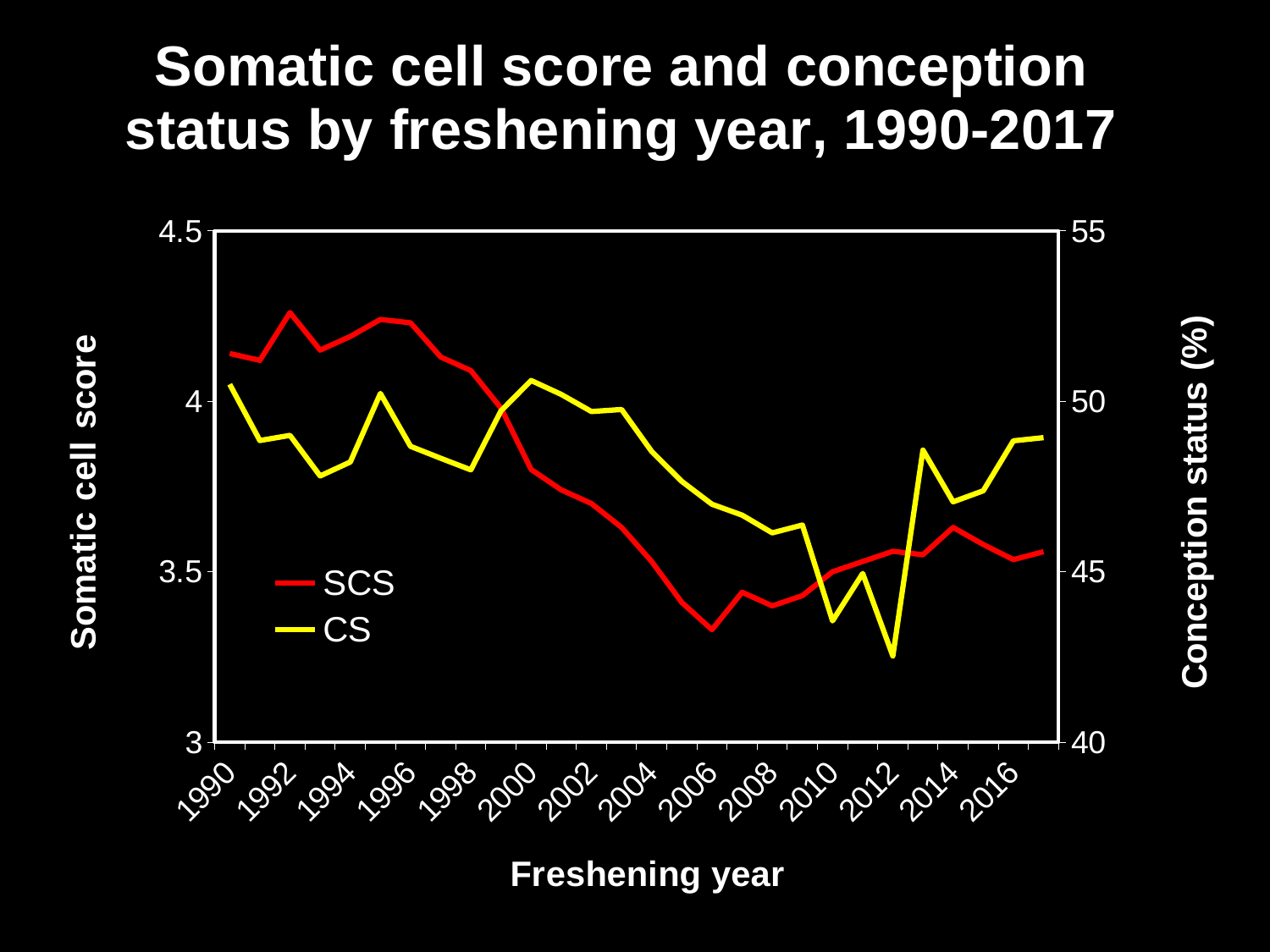
In which year is the CS line at its lowest? 2012 Is the CS value for 2013 greater or less than 45? greater How many series does the legend list? 2 What are the two series named in the legend? SCS and CS Is the CS value for 2012 greater or less than 45? less What is the label of the right-hand vertical axis? Conception status (%) Is the SCS value for 2006 greater or less than 3.5? less What kind of chart is shown on the slide? line chart In which year is the SCS line at its lowest? 2006 How many freshening years are plotted on the chart? 28 Does the SCS line overall rise or fall from 1990 to 2017? fall